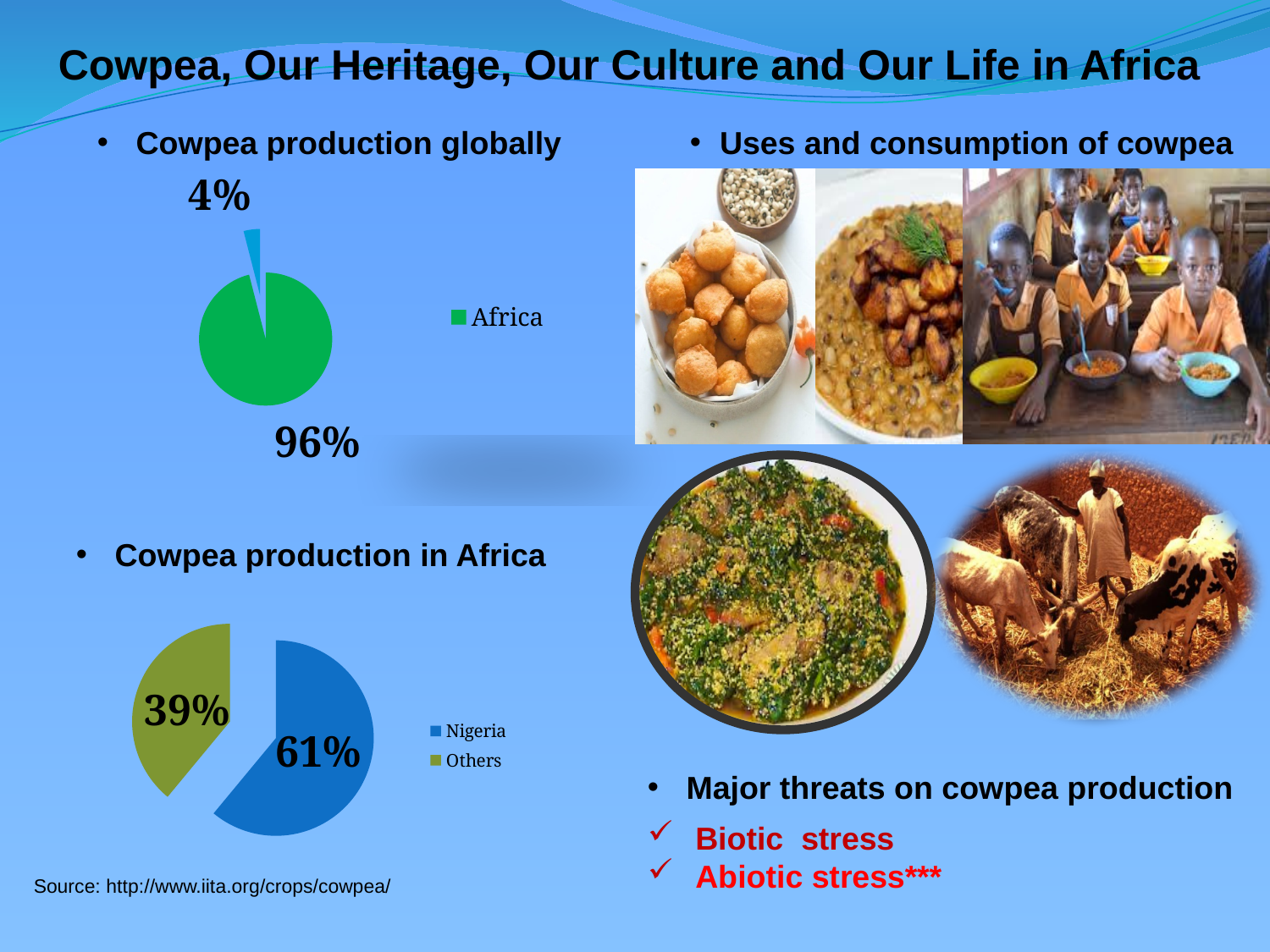
How many entries does the legend of the 'Cowpea production globally' chart list? 1 In the 'Cowpea production in Africa' pie chart, which category has the largest share? Nigeria What type of chart is used for 'Cowpea production globally'? Pie chart In the 'Cowpea production in Africa' pie chart, what is the difference in percentage points between Nigeria and Others? 22 percentage points How many slices does the 'Cowpea production globally' pie chart have? 2 In the 'Cowpea production in Africa' pie chart, which category has the smallest share? Others In the 'Cowpea production in Africa' pie chart, what share is attributed to Others? 39% In the 'Cowpea production in Africa' pie chart, what share does Nigeria account for? 61% How many categories does the legend of the 'Cowpea production in Africa' chart list? 2 In the 'Cowpea production in Africa' pie chart, what colour represents Nigeria? Blue In the 'Cowpea production globally' pie chart, what percentage is shown for the small blue slice? 4% In the 'Cowpea production globally' pie chart, what share of global cowpea production does Africa account for? 96%